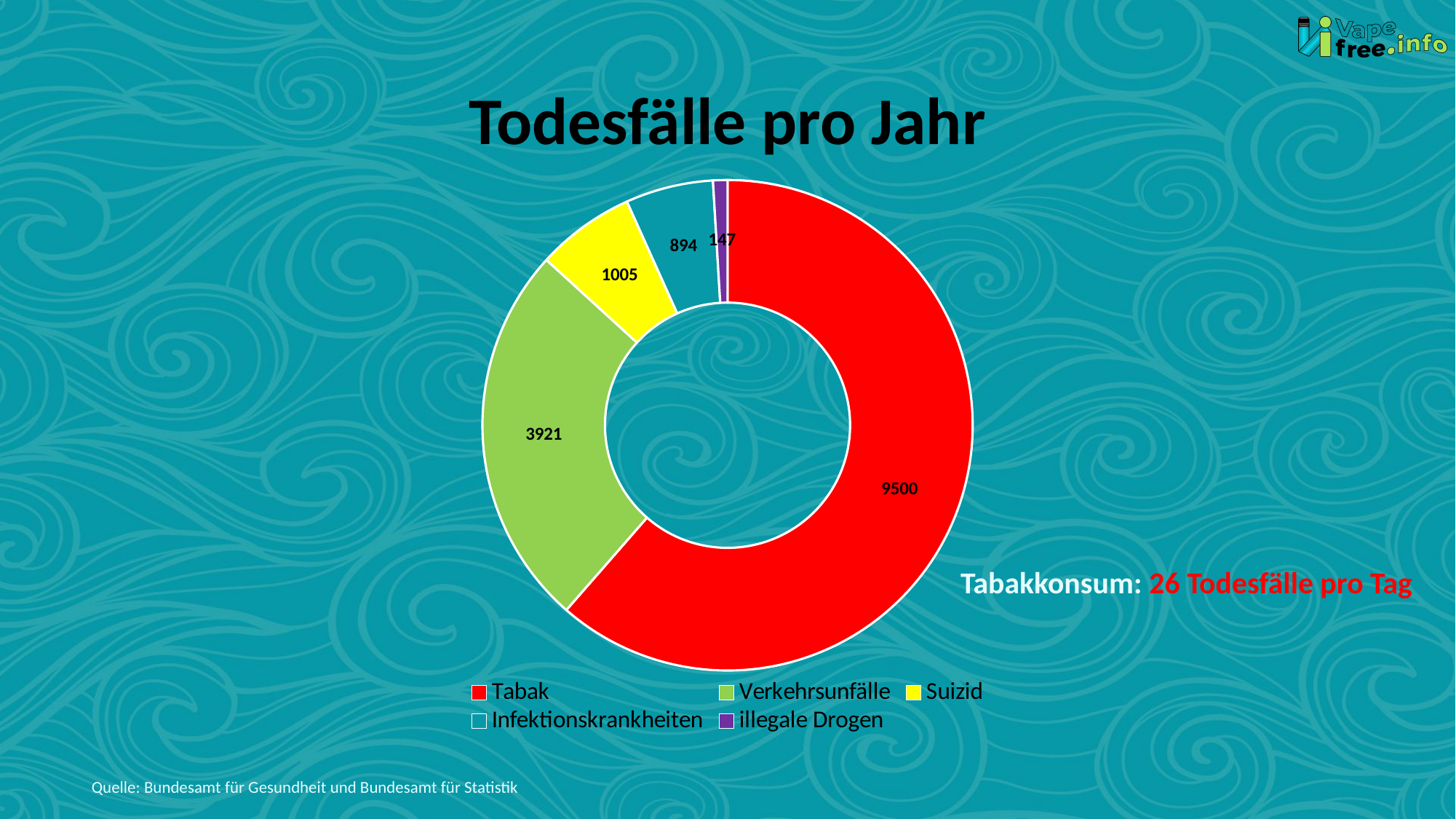
What kind of chart is shown on the slide? Doughnut chart What is the difference between the values for Tabak and Verkehrsunfälle? 5579 What is the value for Suizid? 1005 Which category has the lowest value? illegale Drogen What is the value for Infektionskrankheiten? 894 How many categories does the legend list? 5 Which category has the highest value? Tabak What is the value for illegale Drogen? 147 What is the value for Verkehrsunfälle? 3921 Which is larger, the value for Suizid or the value for Infektionskrankheiten? Suizid What is the value for Tabak? 9500 What is the title of the chart? Todesfälle pro Jahr